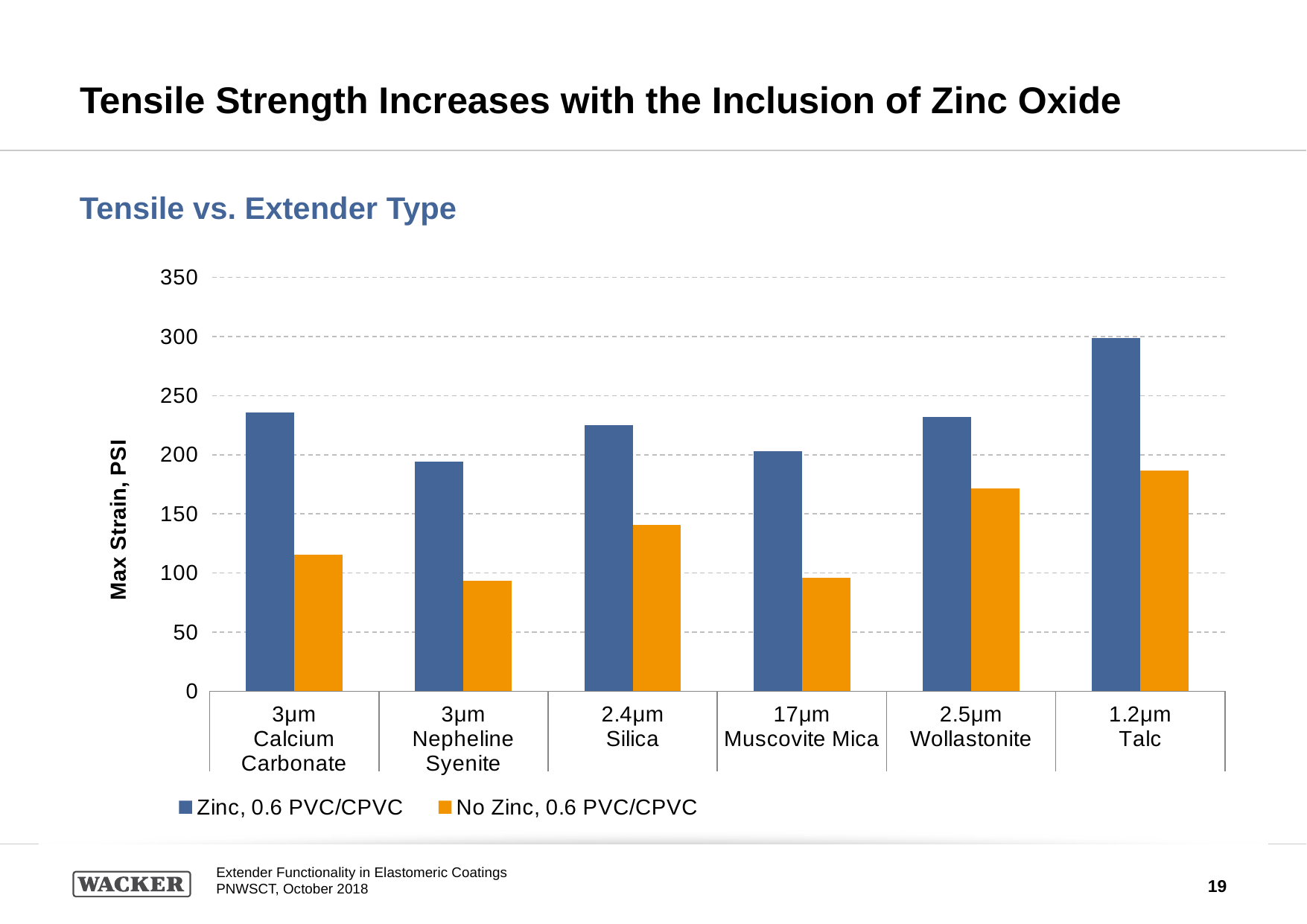
What kind of chart is shown on the slide? bar chart Which extender type has the highest value for the No Zinc, 0.6 PVC/CPVC series? 1.2µm Talc How many series does the legend list? 2 Is the No Zinc, 0.6 PVC/CPVC value for 2.5µm Wollastonite greater or less than 150? greater What is the label of the y axis? Max Strain, PSI For 17µm Muscovite Mica, which series has the larger value: Zinc, 0.6 PVC/CPVC or No Zinc, 0.6 PVC/CPVC? Zinc, 0.6 PVC/CPVC For the No Zinc, 0.6 PVC/CPVC series, which is larger: 2.5µm Wollastonite or 2.4µm Silica? 2.5µm Wollastonite Which extender type has the highest value for the Zinc, 0.6 PVC/CPVC series? 1.2µm Talc How many extender types are shown on the x axis? 6 Is the Zinc, 0.6 PVC/CPVC value for 3µm Calcium Carbonate greater or less than 200? greater Is the No Zinc, 0.6 PVC/CPVC value for 3µm Nepheline Syenite greater or less than 150? less